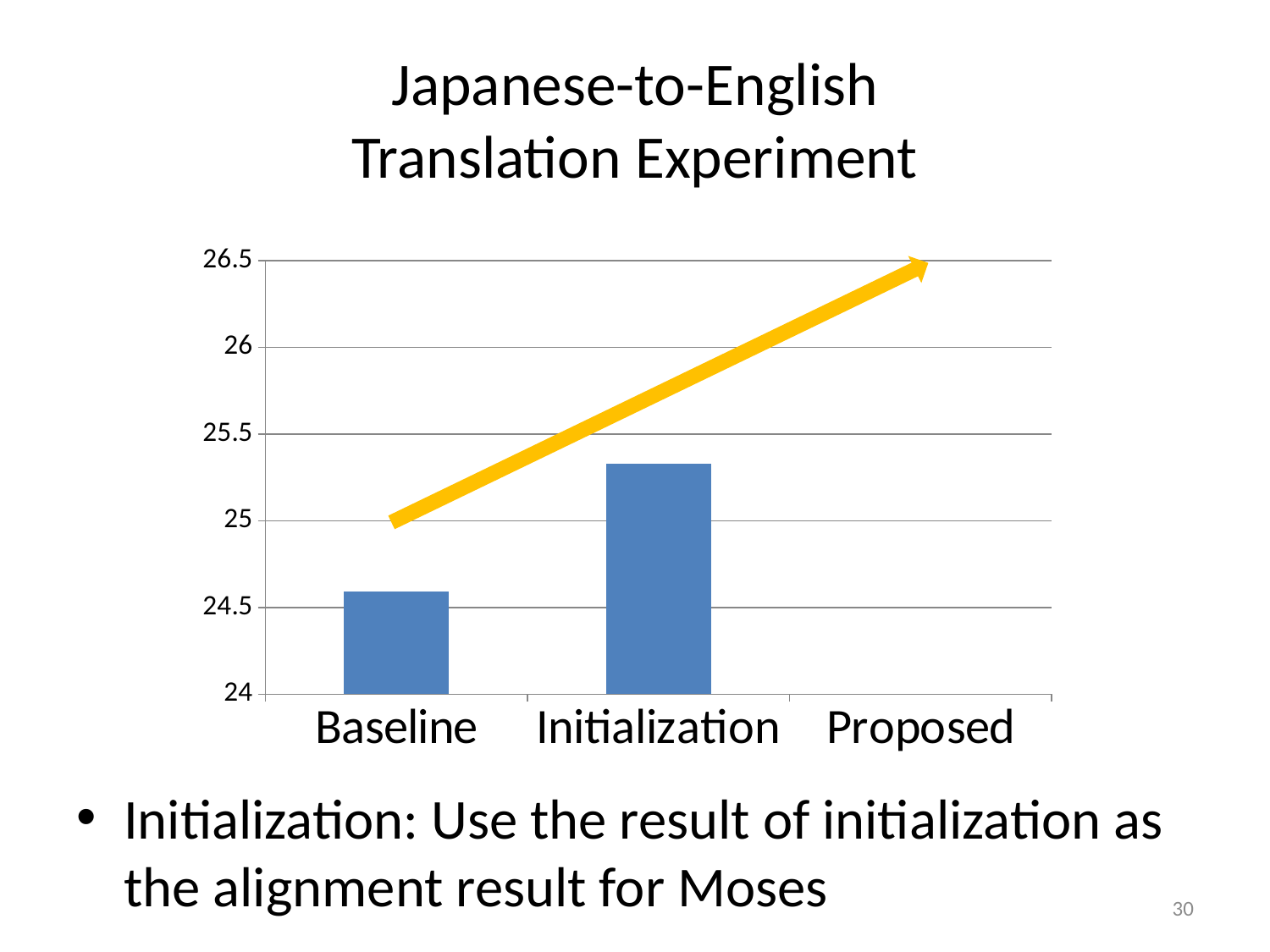
Is the value for Initialization greater or less than 25.5? less Which of the plotted bars is the lowest? Baseline Is the value for Initialization greater or less than 25? greater Which category on the x axis has no bar plotted? Proposed Which of the plotted bars is the highest? Initialization Which is larger, the value for Baseline or the value for Initialization? Initialization What kind of chart is shown on the slide? bar chart Is the value for Baseline greater or less than 25? less How many categories are labelled on the x axis of the chart? 3 Do the bar values rise or fall from Baseline to Initialization? rise What colour is the arrow drawn over the chart? yellow